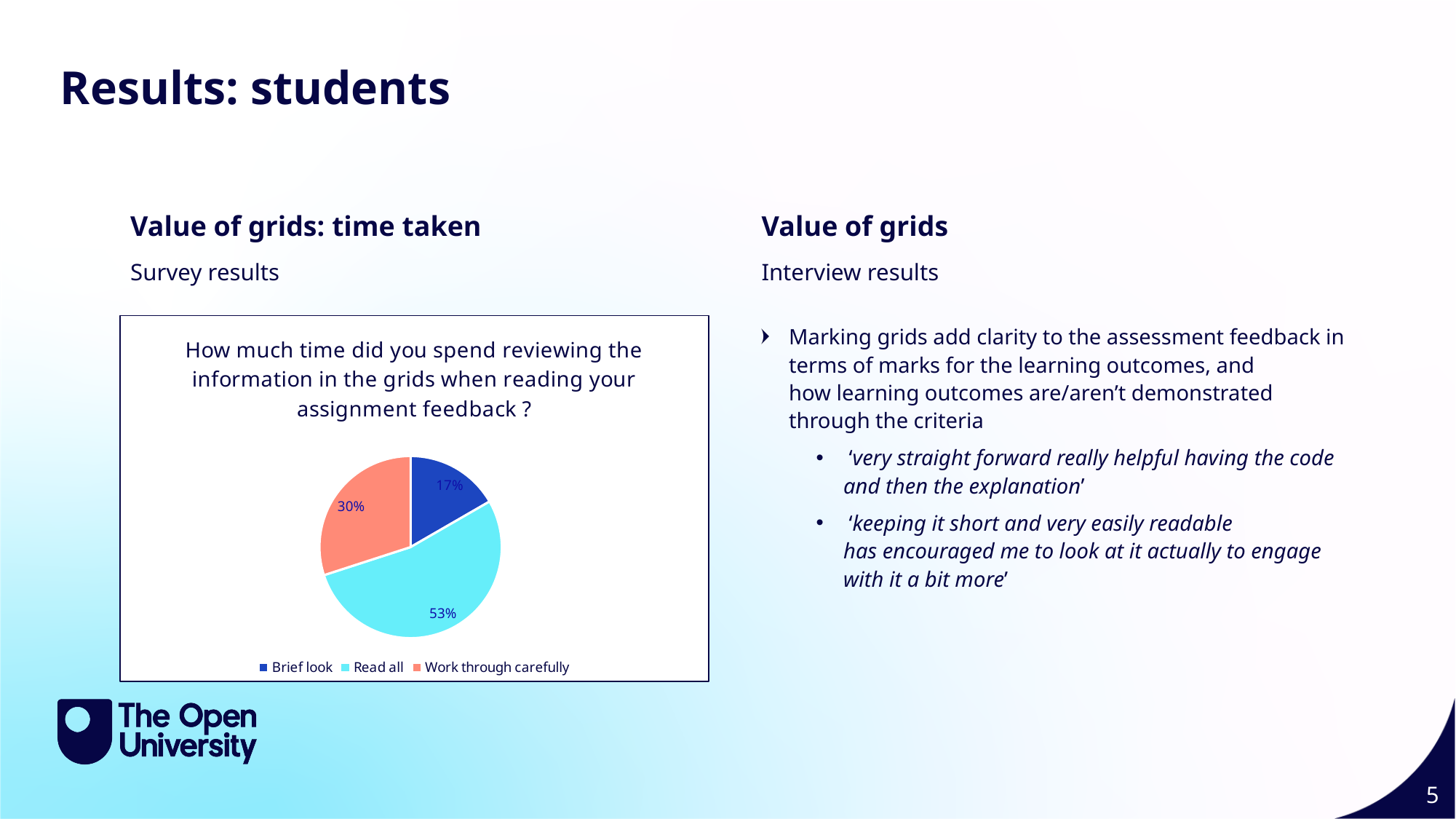
How many categories does the pie chart show? 3 Which is larger, the share for 'Work through carefully' or the share for 'Brief look'? Work through carefully Which colour represents 'Work through carefully' in the pie chart? salmon/orange What is the difference in percentage points between 'Read all' and 'Work through carefully'? 23 Which category has the smallest share of the pie? Brief look What type of chart is shown on the slide? pie chart What is the title of the pie chart? How much time did you spend reviewing the information in the grids when reading your assignment feedback ? What is the difference in percentage points between 'Work through carefully' and 'Brief look'? 13 What percentage of students said they worked through the grids carefully? 30% What percentage of students said they read all of the grids? 53% Which category has the largest share of the pie? Read all What percentage of students said they took a brief look at the grids? 17%